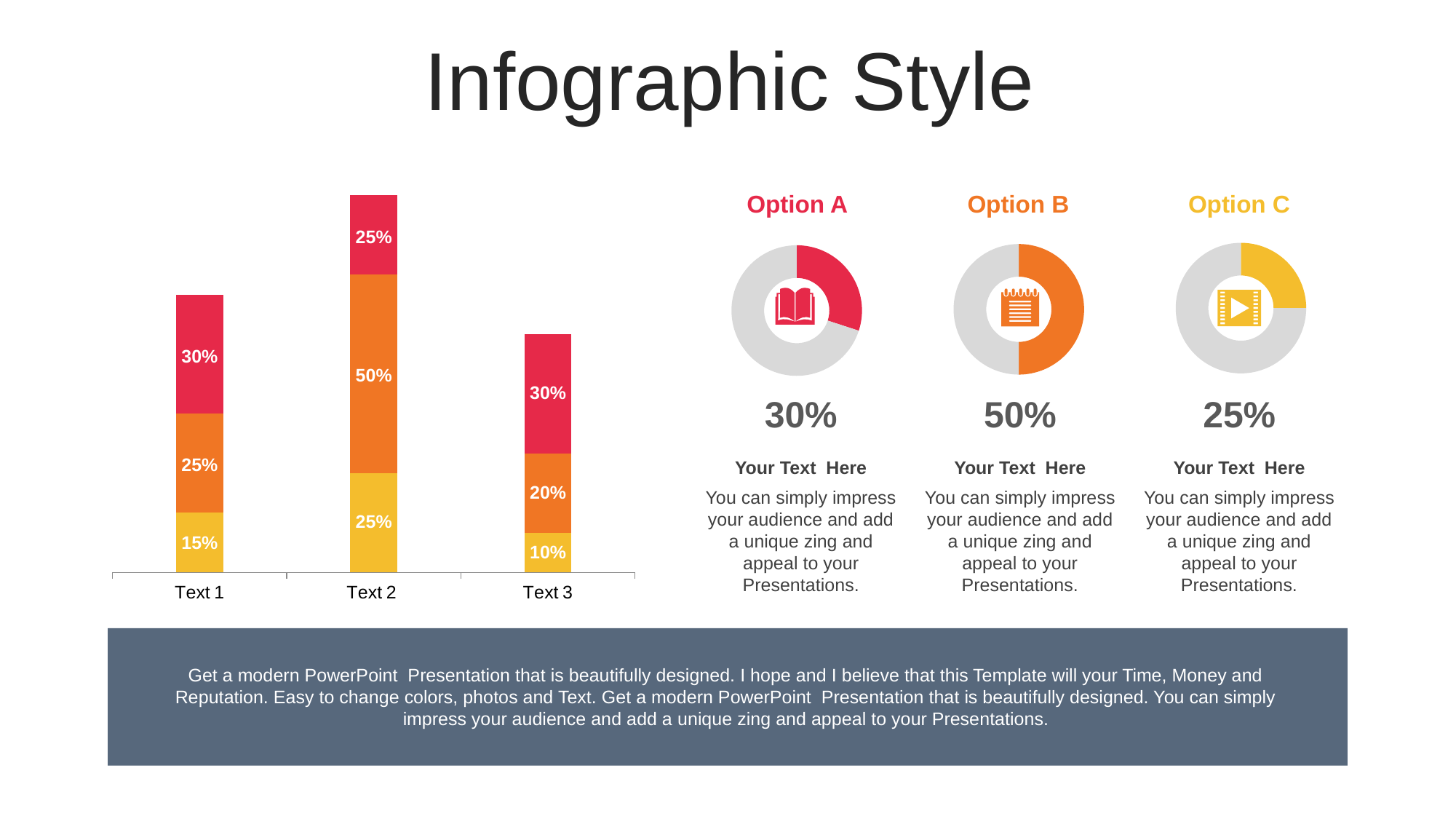
In the bar chart, what is the value of the orange (middle) segment for Text 2? 50% In the bar chart, is the yellow segment for Text 2 larger or smaller than the yellow segment for Text 1? larger In the bar chart, what is the value of the yellow (bottom) segment for Text 1? 15% In the bar chart, which category has the tallest stacked bar? Text 2 In the bar chart, what is the value of the red (top) segment for Text 3? 30% How many categories are shown on the x axis of the bar chart? 3 In the bar chart, what is the difference between the orange segment for Text 2 and the orange segment for Text 3? 30% In the bar chart, which category has the shortest stacked bar? Text 3 What type of chart is shown on the left of the slide? stacked bar chart In the bar chart, what is the total of the stacked bar for Text 1? 70% In the bar chart, what is the value of the yellow (bottom) segment for Text 3? 10% In the bar chart, what is the total of the stacked bar for Text 2? 100%